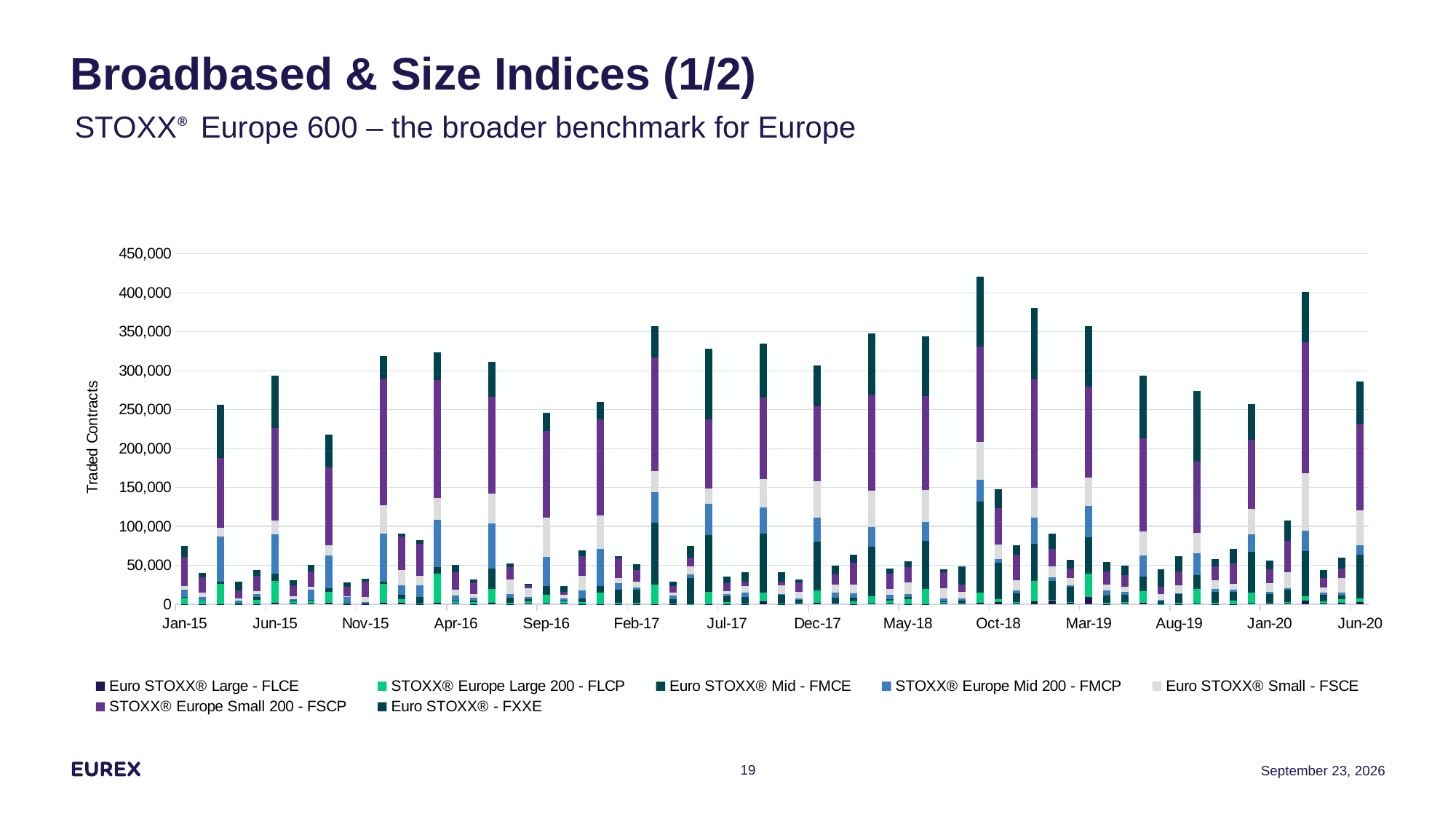
Is the total value for Oct-18 greater or less than 200,000? less What is the label on the vertical axis of the chart? Traded Contracts Is the total value for Mar-19 greater or less than 300,000? greater Is the tallest bar in the chart greater or less than 400,000? greater What kind of chart is shown on the slide? Stacked bar chart How many series does the legend list? 7 Which month is the first label on the x axis of the chart? Jan-15